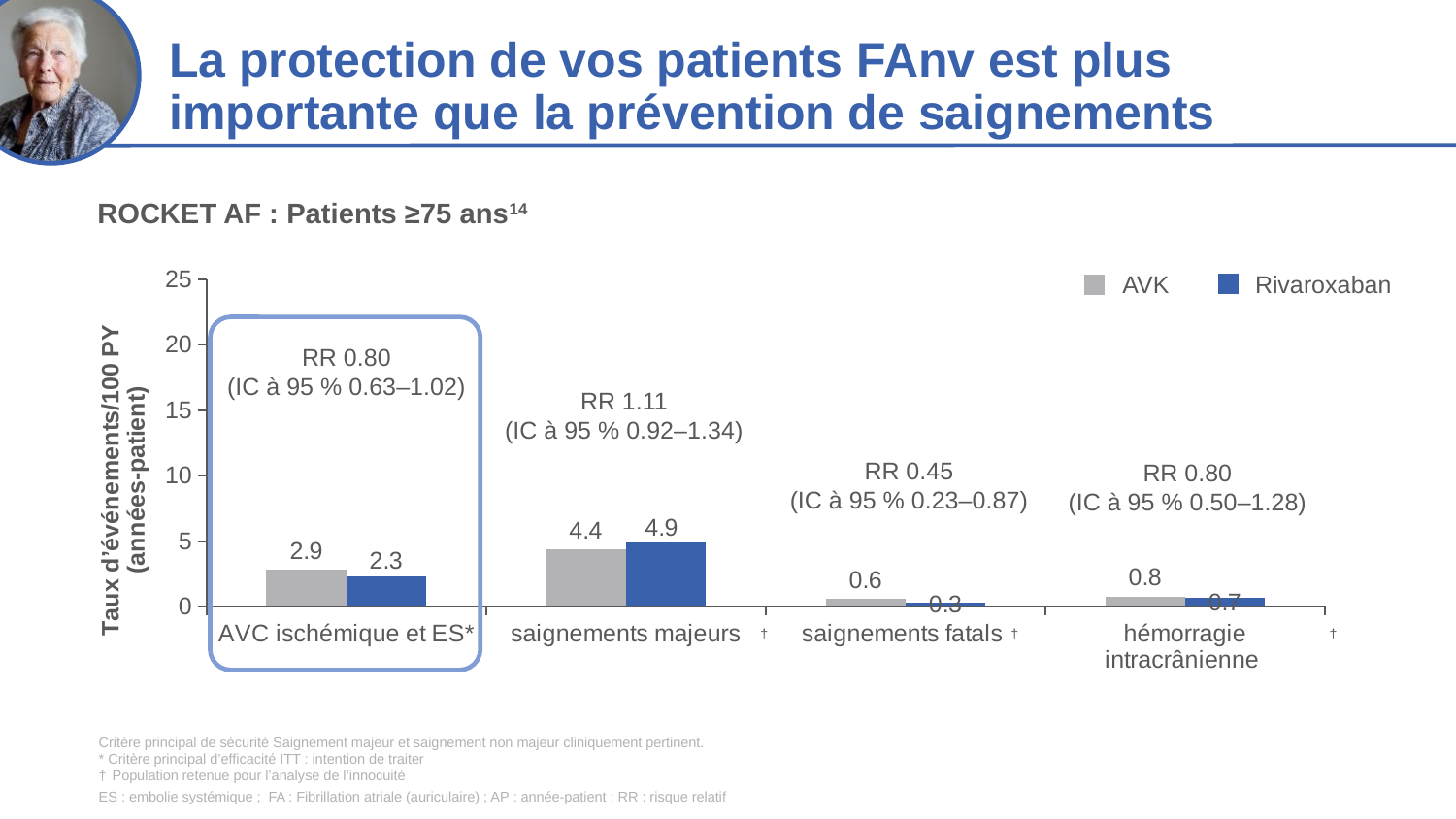
For AVC ischémique et ES*, which series has the larger event rate, AVK or Rivaroxaban? AVK How many series does the legend list? 2 What is the AVK event rate for saignements fatals? 0.6 What is the Rivaroxaban event rate for AVC ischémique et ES*? 2.3 Which category has the highest AVK event rate? saignements majeurs What kind of chart is shown on the slide? bar chart What is the AVK event rate for saignements majeurs? 4.4 What is the Rivaroxaban event rate for saignements majeurs? 4.9 What is the AVK event rate for AVC ischémique et ES*? 2.9 Which category has the lowest AVK event rate? saignements fatals What is the AVK event rate for hémorragie intracrânienne? 0.8 What is the difference between the AVK and Rivaroxaban event rates for saignements majeurs? 0.5